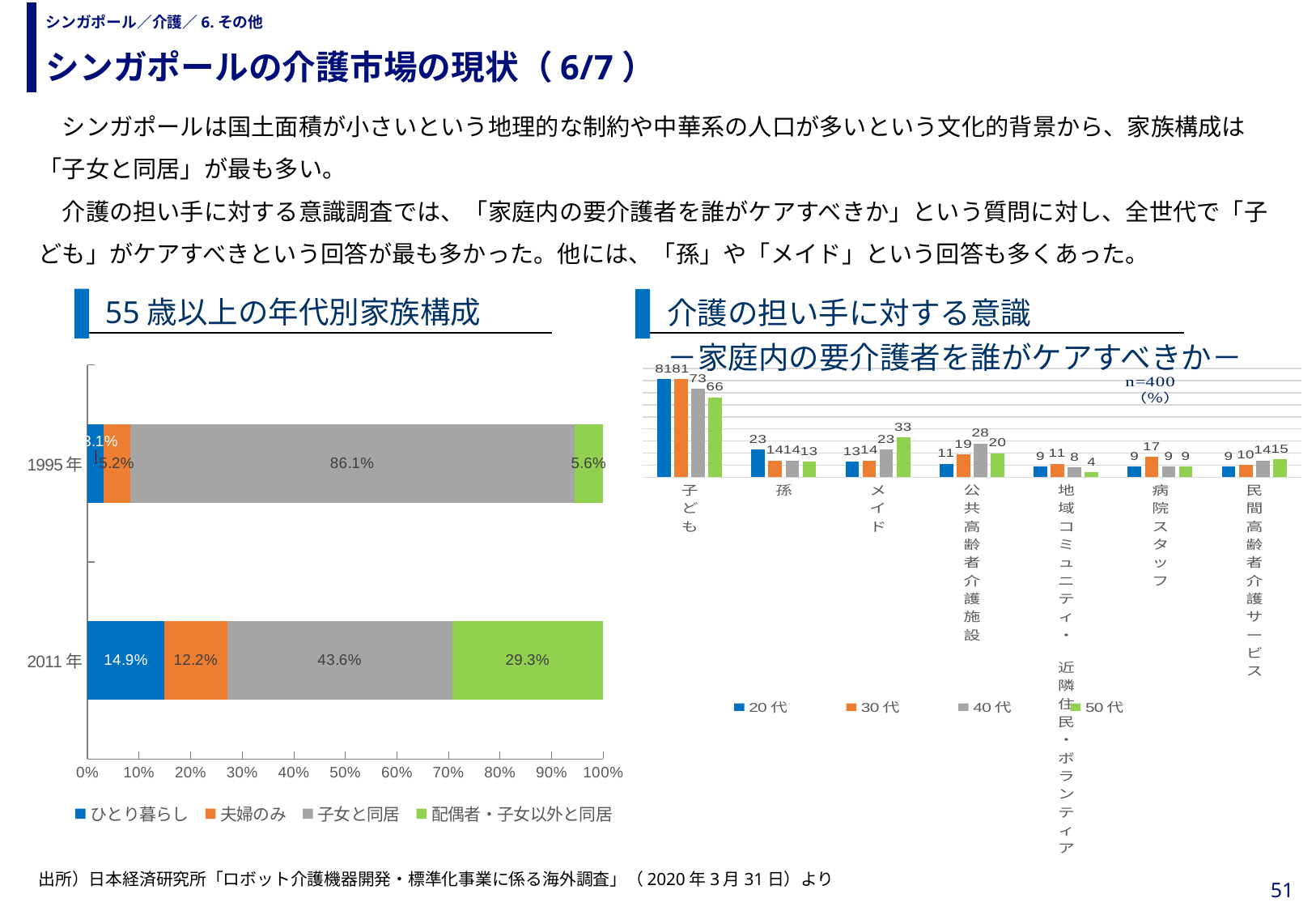
In the chart titled 「55歳以上の年代別家族構成」, what is the value for 配偶者・子女以外と同居 in 1995年? 5.6% In the chart titled 「55歳以上の年代別家族構成」, what is the value for 子女と同居 in 2011年? 43.6% In the chart titled 「介護の担い手に対する意識」, what is the difference between the 20代 and 50代 values for 子ども? 15 In the chart titled 「55歳以上の年代別家族構成」, what is the difference between the 子女と同居 values for 1995年 and 2011年? 42.5 percentage points In the chart titled 「介護の担い手に対する意識」, what is the value for 30代 in the 病院スタッフ category? 17 In the chart titled 「介護の担い手に対する意識」, which category has the highest value for 20代? 子ども In the chart titled 「介護の担い手に対する意識」, which category has the lowest value for 50代? 地域コミュニティ・近隣住民・ボランティア In the chart titled 「介護の担い手に対する意識」, how many categories are shown on the x axis? 7 In the chart titled 「55歳以上の年代別家族構成」, how many series does the legend list? 4 What kind of chart is the chart titled 「55歳以上の年代別家族構成」? Stacked bar chart In the chart titled 「介護の担い手に対する意識」, what is the value for 50代 in the メイド category? 33 In the chart titled 「55歳以上の年代別家族構成」, which is larger in 2011年: ひとり暮らし or 夫婦のみ? ひとり暮らし